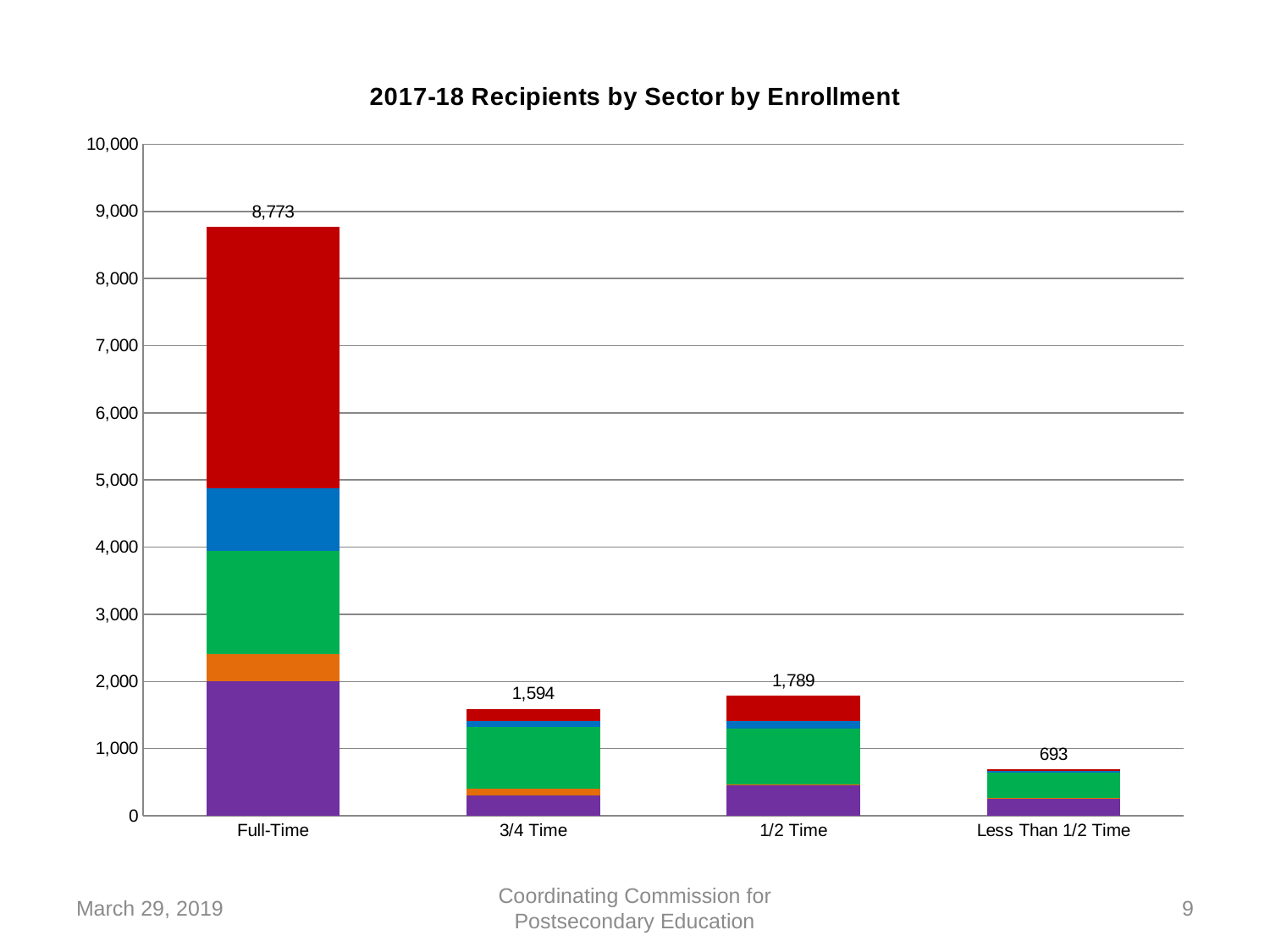
Which enrollment category has the lowest total number of recipients? Less Than 1/2 Time Which enrollment category has the highest total number of recipients? Full-Time What is the total number of recipients for 1/2 Time enrollment? 1,789 What is the total number of recipients for 3/4 Time enrollment? 1,594 What is the total number of recipients for Less Than 1/2 Time enrollment? 693 Which has a larger total, 3/4 Time or 1/2 Time? 1/2 Time What is the difference between the totals for 1/2 Time and Less Than 1/2 Time? 1,096 What is the title of the chart? 2017-18 Recipients by Sector by Enrollment How many enrollment categories are shown on the x axis? 4 What is the difference between the totals for Full-Time and 3/4 Time? 7,179 What is the total number of recipients for Full-Time enrollment? 8,773 What kind of chart is shown on the slide? Stacked bar chart